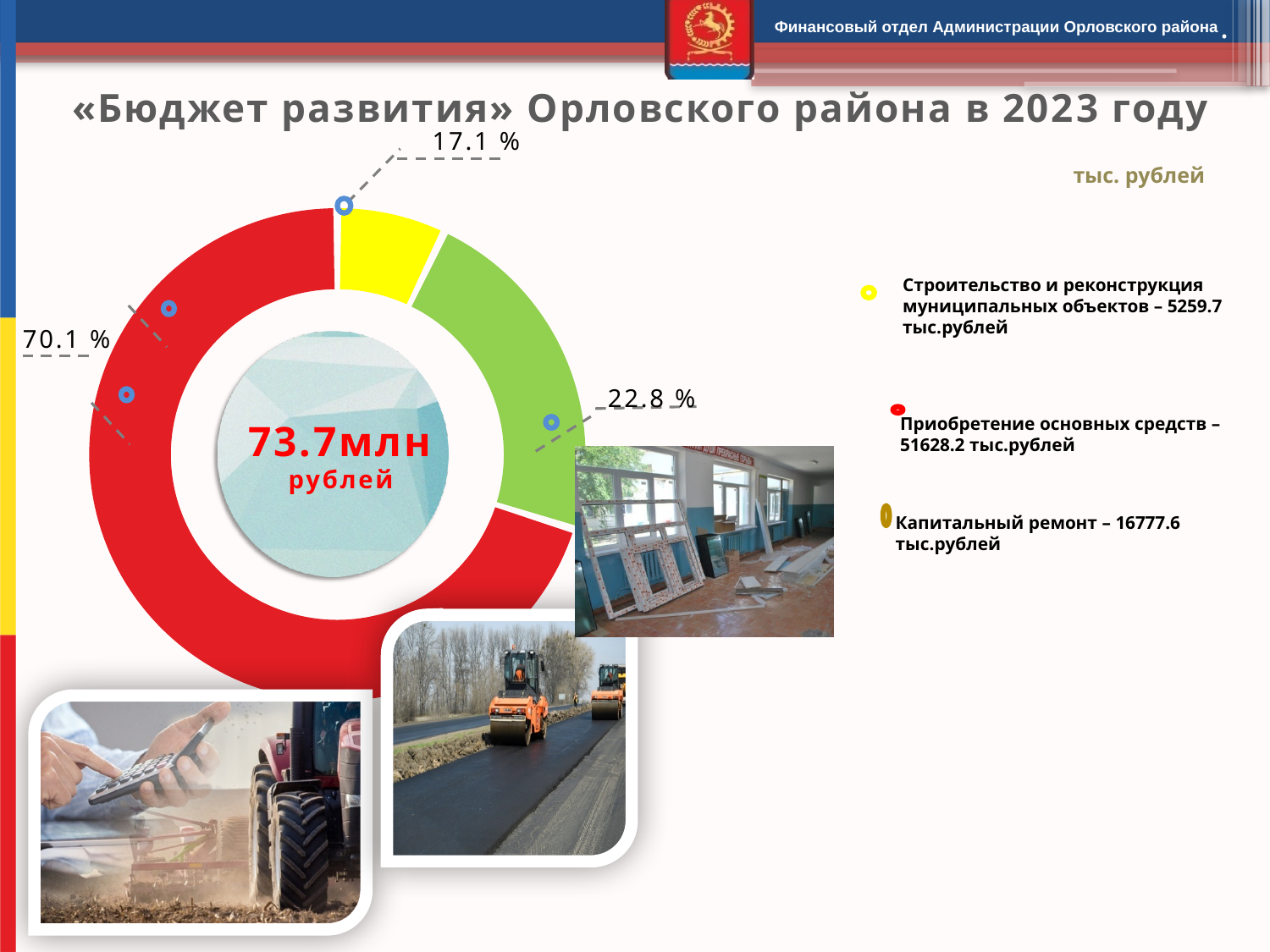
What is the value for Приобретение основных средств? 51628.2 тыс.рублей What percentage share does Капитальный ремонт have in the pie chart? 22.8 % What is the value for Строительство и реконструкция муниципальных объектов? 5259.7 тыс.рублей How many slices does the pie chart have? 3 What is the value for Капитальный ремонт? 16777.6 тыс.рублей What colour is the slice for Приобретение основных средств? red What percentage share does Приобретение основных средств have in the pie chart? 70.1 % What total amount is shown in the centre of the pie chart? 73.7 млн рублей What kind of chart is shown on the slide? doughnut chart Which category has the largest share of the pie chart? Приобретение основных средств Which category has the smallest share of the pie chart? Строительство и реконструкция муниципальных объектов What is the difference between the values for Приобретение основных средств and Капитальный ремонт? 34850.6 тыс.рублей